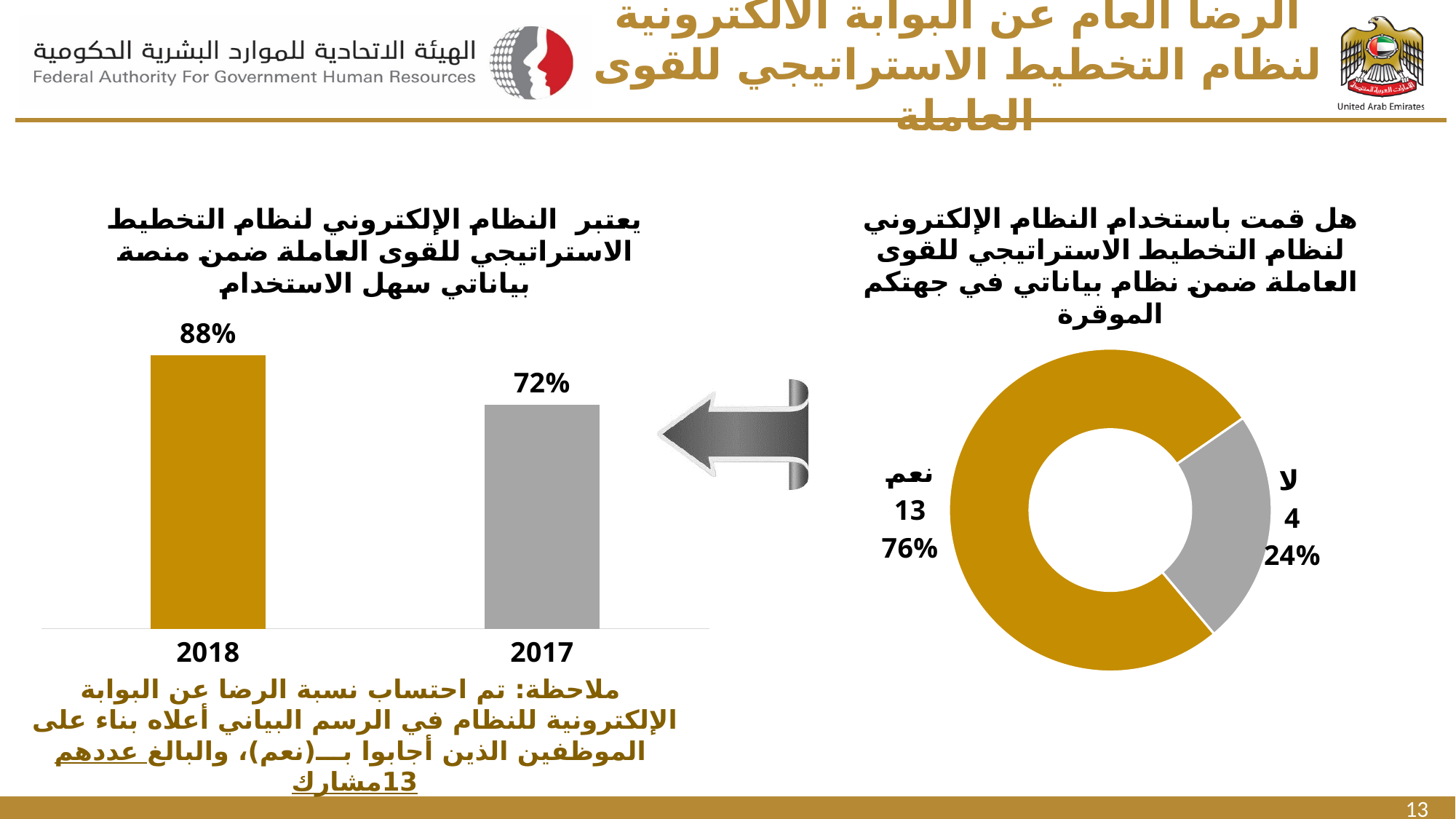
In the bar chart on the left, which year has the higher value? 2018 In the bar chart on the left, what is the difference between the 2018 and 2017 values? 16% In the doughnut chart on the right, how many respondents answered 'لا'? 4 In the bar chart on the left, what is the value for 2017? 72% In the doughnut chart on the right, what colour is the 'لا' slice? Grey In the doughnut chart on the right, what percentage share does the 'نعم' slice have? 76% In the bar chart on the left, how many bars are shown? 2 What type of chart is shown on the left side of the slide? Bar chart In the doughnut chart on the right, which slice is larger, 'نعم' or 'لا'? نعم In the bar chart on the left, what is the value for 2018? 88% In the doughnut chart on the right, how many respondents answered 'نعم'? 13 In the doughnut chart on the right, what percentage share does the 'لا' slice have? 24%